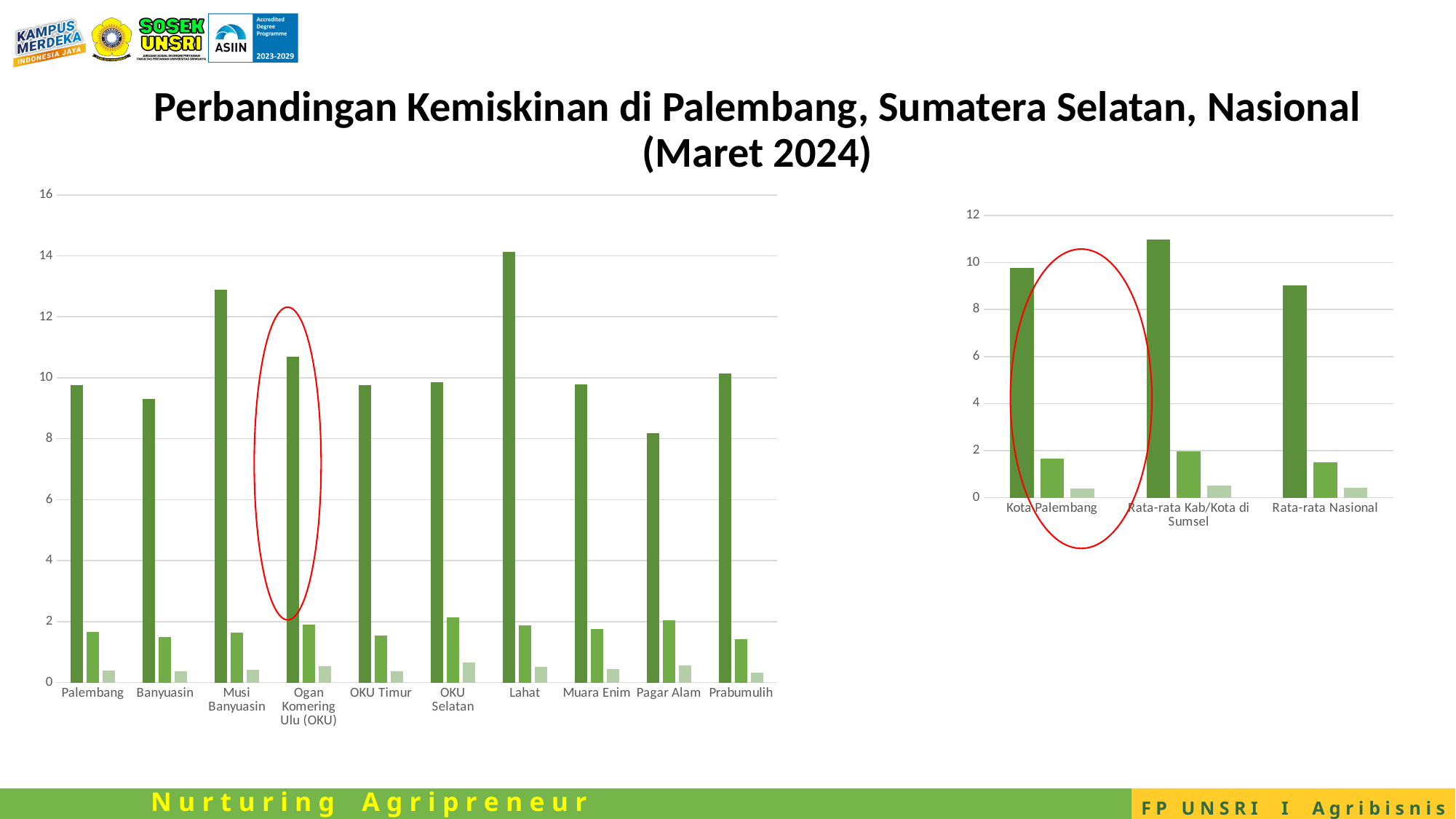
In the right chart, which category has the shortest dark green bar? Rata-rata Nasional How many categories are shown on the x axis of the left chart? 10 In the left chart, is the dark green bar for Pagar Alam greater or less than 10? less What kind of chart is the left chart on the slide? bar chart In the right chart, is the dark green bar for Rata-rata Kab/Kota di Sumsel greater or less than 10? greater In the left chart, which has a taller dark green bar, Musi Banyuasin or Banyuasin? Musi Banyuasin In the left chart, which category has the tallest dark green bar? Lahat In the left chart, which category is circled in red? Ogan Komering Ulu (OKU) How many categories are shown on the x axis of the right chart? 3 In the right chart, which category has the tallest dark green bar? Rata-rata Kab/Kota di Sumsel In the left chart, which category has the shortest dark green bar? Pagar Alam